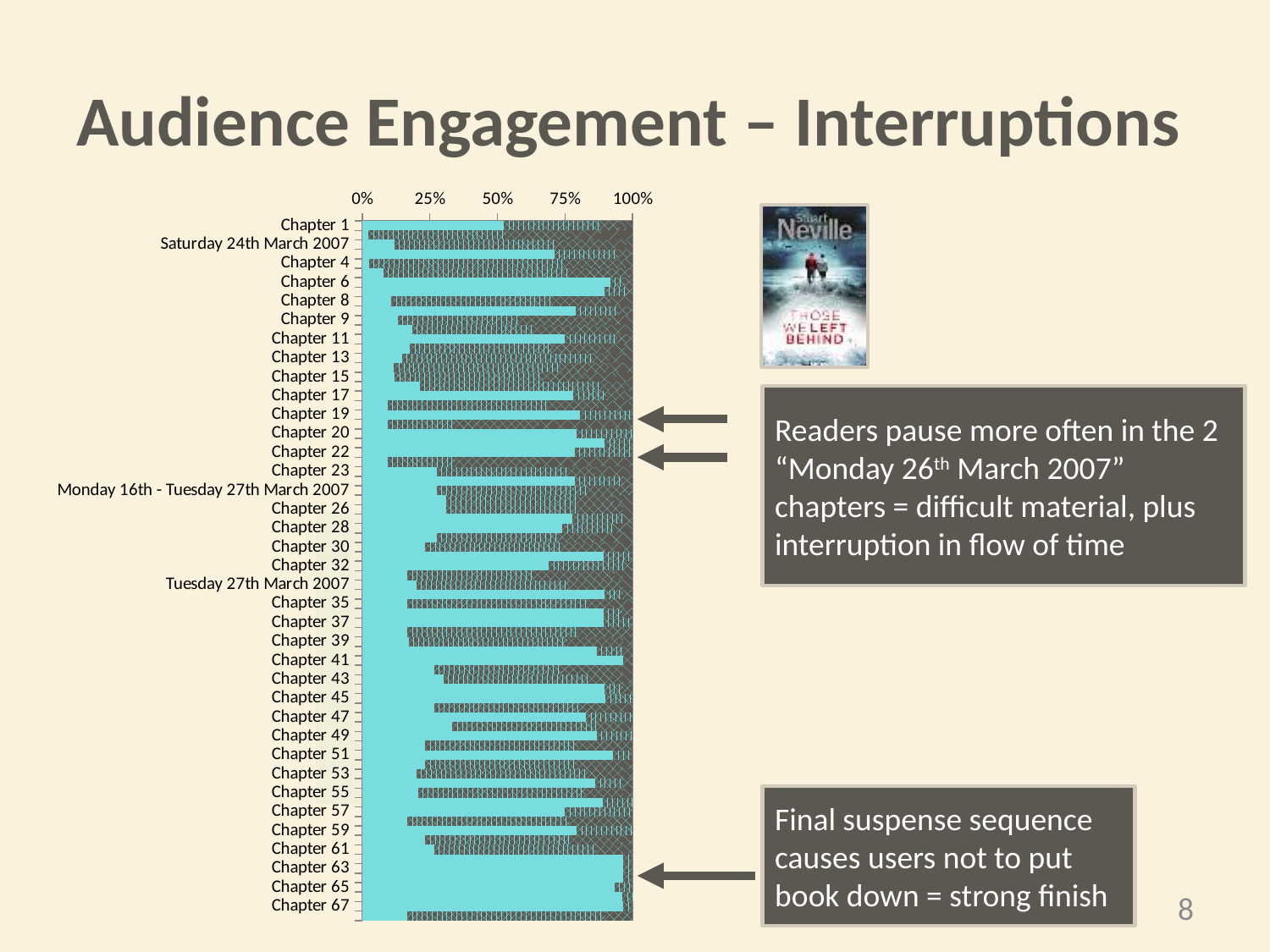
Is the solid (unpatterned) portion of the bar for Chapter 19 greater or less than 25%? greater Is the solid (unpatterned) portion of the bar for Chapter 20 greater or less than 25%? greater Is the solid (unpatterned) portion of the bar for Chapter 65 greater or less than 75%? greater What kind of chart is shown on the slide? bar chart What is the highest value shown on the chart's percentage axis? 100% Which has the larger solid (unpatterned) portion of its bar, Chapter 6 or Chapter 20? Chapter 6 Which has the larger solid (unpatterned) portion of its bar, Chapter 19 or Chapter 45? Chapter 45 Which has the larger solid (unpatterned) portion of its bar, Chapter 63 or Chapter 23? Chapter 63 What is the title of the slide containing the chart? Audience Engagement – Interruptions